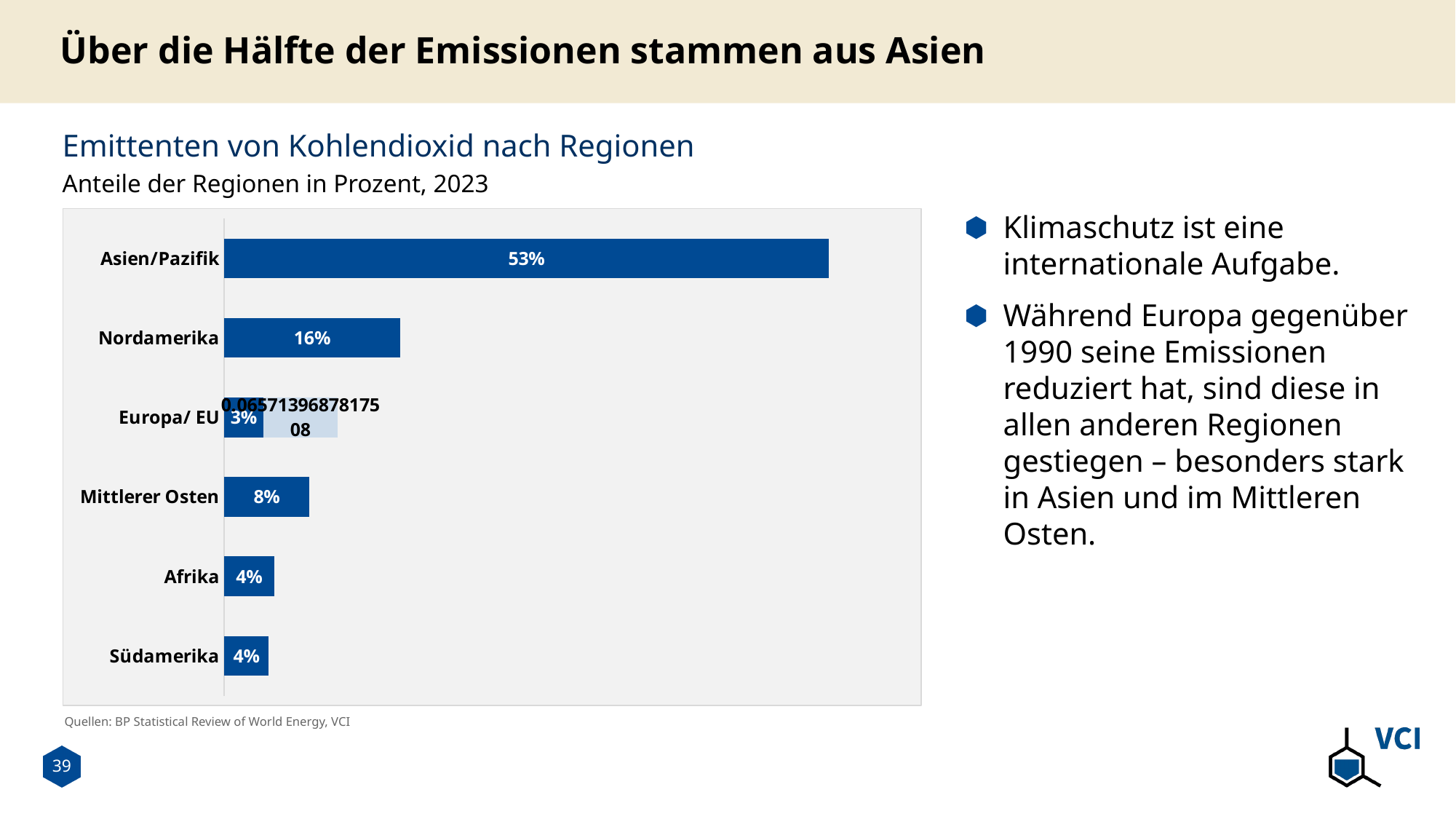
What is the title of the chart? Emittenten von Kohlendioxid nach Regionen What kind of chart is shown on the slide? Bar chart What is the value for Asien/Pazifik? 53% What is the value for Mittlerer Osten? 8% What is the value for Nordamerika? 16% What is the value for Afrika? 4% Which region has the highest share? Asien/Pazifik What is the value for Südamerika? 4% Which is larger, the value for Nordamerika or the value for Mittlerer Osten? Nordamerika Which year does the chart's data refer to? 2023 How many regions are shown in the chart? 6 What is the difference between the values for Asien/Pazifik and Nordamerika? 37 percentage points